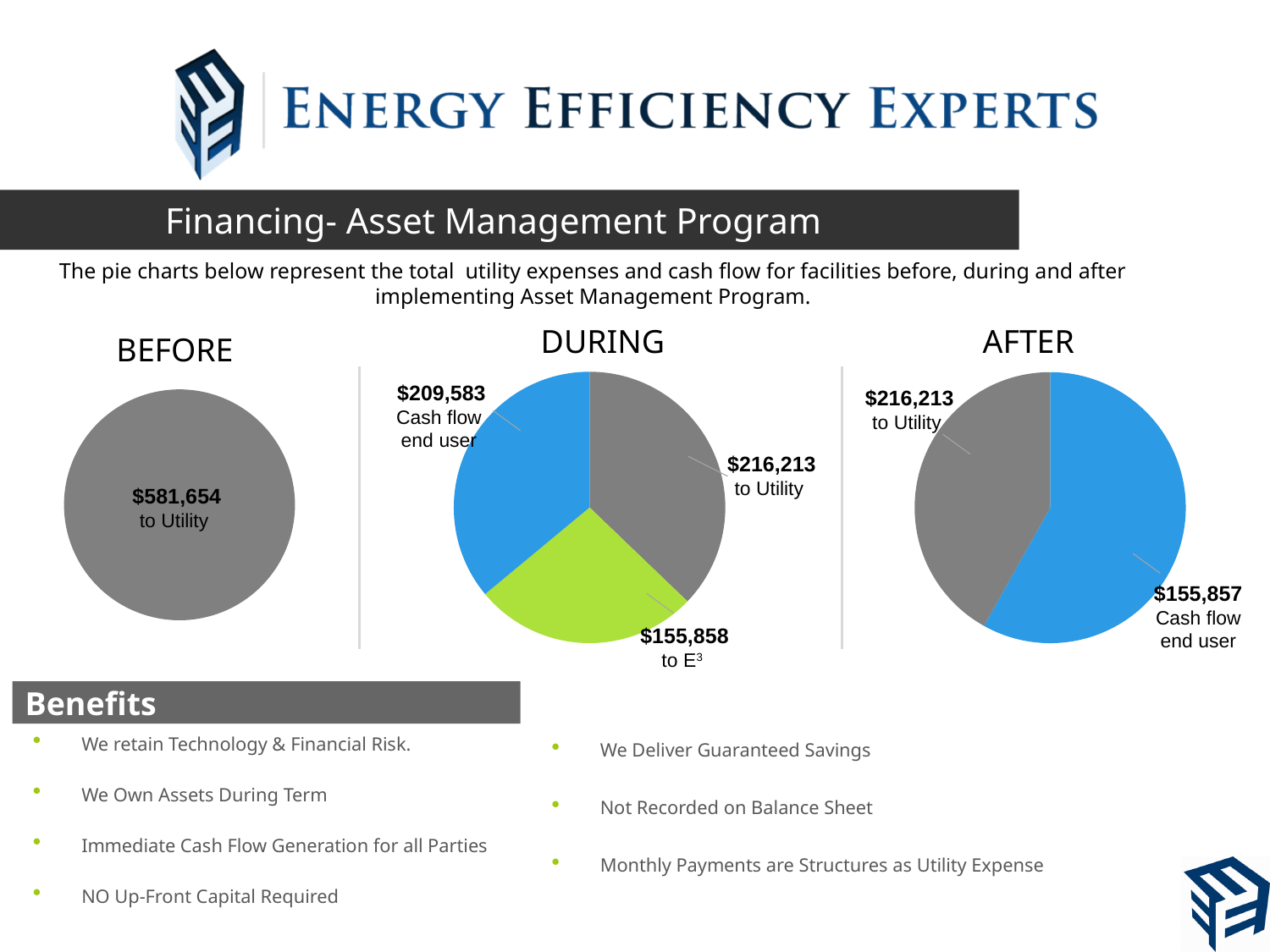
In the DURING pie chart, which slice has the smallest value? to E³ What type of chart is used for the BEFORE, DURING and AFTER figures? Pie chart In the DURING pie chart, what is the value of the Cash flow end user slice? $209,583 How many slices does the DURING pie chart have? 3 In the AFTER pie chart, what is the difference between the to Utility value and the Cash flow end user value? $60,356 In the BEFORE pie chart, what is the value shown for the amount to Utility? $581,654 In the AFTER pie chart, what colour is the Cash flow end user slice? Blue In the DURING pie chart, which slice has the largest value? to Utility In the DURING pie chart, what is the value of the slice labelled to E³? $155,858 In the DURING pie chart, what is the total of all three slices? $581,654 In the AFTER pie chart, what is the value of the Cash flow end user slice? $155,857 In the DURING pie chart, which is larger: the to Utility slice or the Cash flow end user slice? to Utility